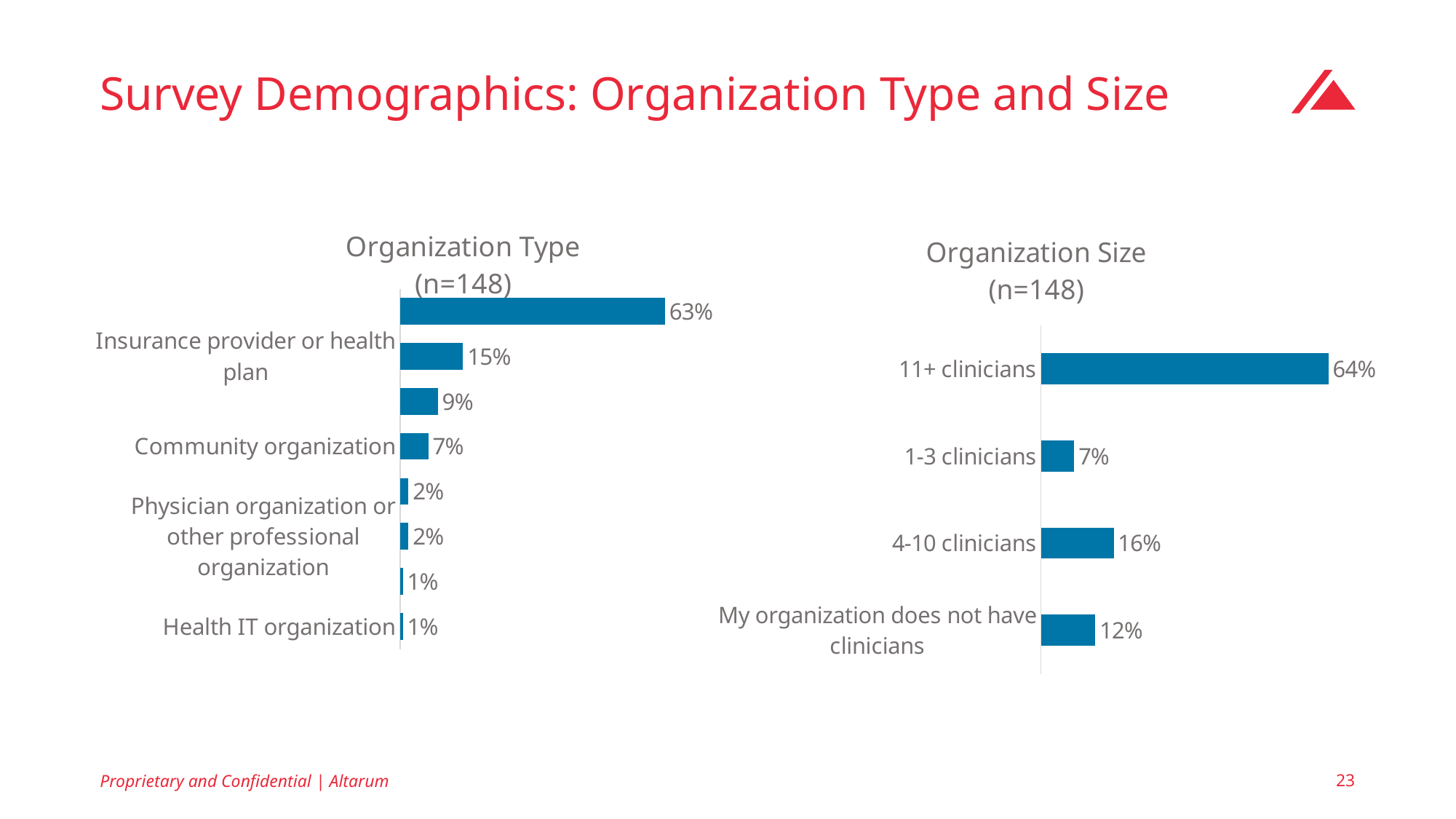
In the Organization Size chart, which category has the highest value? 11+ clinicians In the Organization Size chart, what percentage of organizations do not have clinicians? 12% In the Organization Size chart, what is the difference between the values for 11+ clinicians and 4-10 clinicians? 48% What is the highest value shown in the Organization Type chart? 63% What type of chart is the Organization Type chart? Bar chart In the Organization Size chart, which is larger: the value for 4-10 clinicians or the value for organizations without clinicians? 4-10 clinicians How many categories are shown in the Organization Size chart? 4 In the Organization Type chart, what is the value for Community organization? 7% In the Organization Size chart, what is the value for 4-10 clinicians? 16% In the Organization Size chart, what percentage of respondents have 11+ clinicians? 64% In the Organization Size chart, which category has the lowest value? 1-3 clinicians In the Organization Size chart, what is the value for 1-3 clinicians? 7%